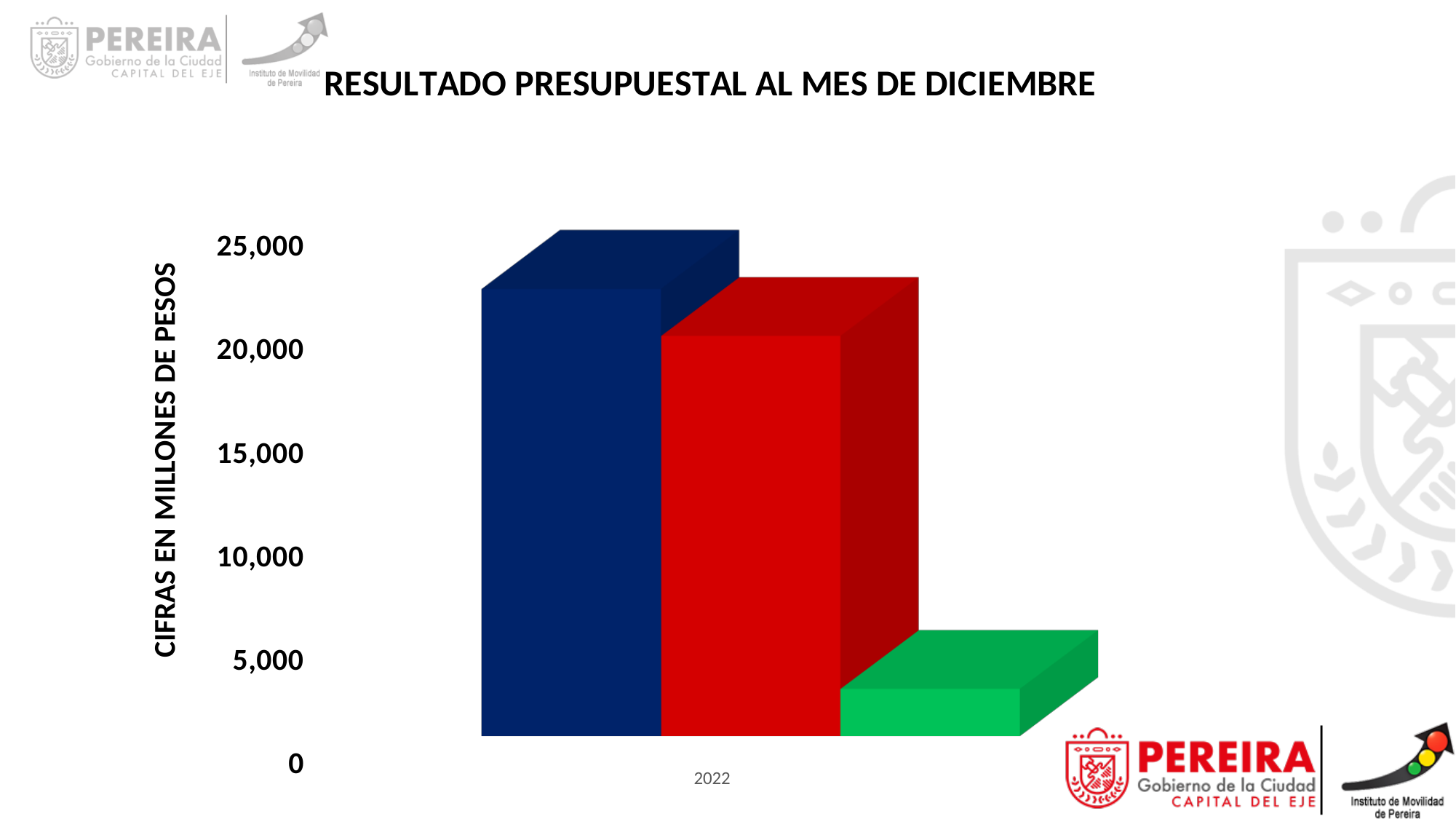
Is the value of the red bar greater or less than 15,000? greater What is the label on the vertical axis of the chart? CIFRAS EN MILLONES DE PESOS Which bar is the shortest in the chart? the green bar Is the value of the green bar greater or less than 5,000? less How many bars are plotted in the chart? 3 Which is larger, the red bar or the green bar? the red bar What category label appears on the horizontal axis of the chart? 2022 What is the title of the chart? RESULTADO PRESUPUESTAL AL MES DE DICIEMBRE What kind of chart is shown on the slide? bar chart Is the value of the blue bar greater or less than 20,000? greater Which bar is the tallest in the chart? the blue bar Which is larger, the blue bar or the red bar? the blue bar